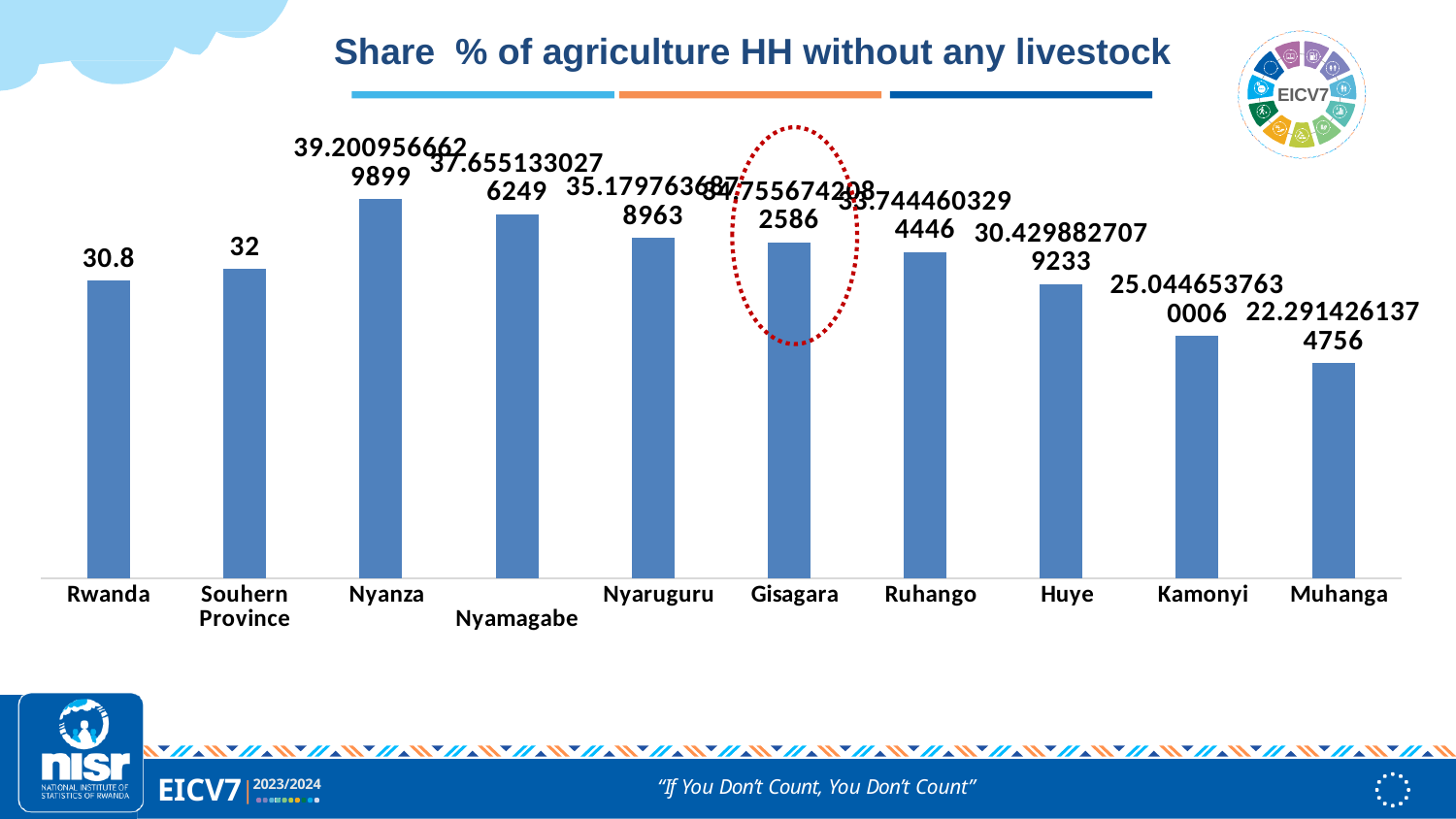
What is the value for Rwanda? 30.8 Which category has the highest value? Nyanza What is the value for Muhanga? 22.2914261374756 What is the value for Nyanza? 39.2009566629899 What is the difference between the values for Souhern Province and Rwanda? 1.2 What is the title of the chart? Share % of agriculture HH without any livestock What is the value for Souhern Province? 32 What type of chart is shown on the slide? bar chart Which category has the lowest value? Muhanga Which has a larger value, Nyamagabe or Huye? Nyamagabe What is the value for Kamonyi? 25.0446537630006 How many categories are shown on the x axis of the chart? 10